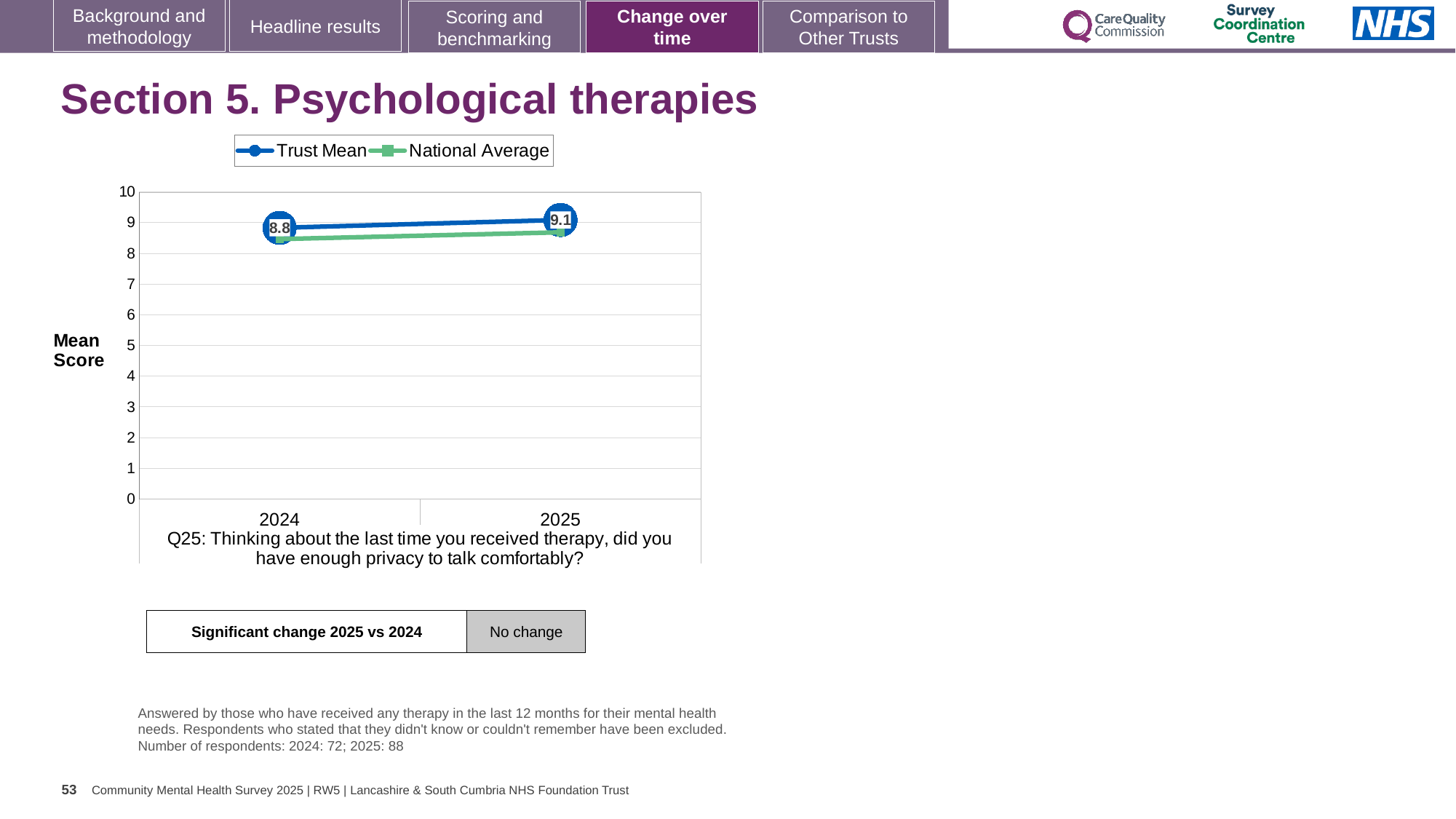
Does the Trust Mean rise or fall from 2024 to 2025? rise Which year has the higher Trust Mean, 2024 or 2025? 2025 How many series does the chart legend list? 2 Is the National Average value for 2025 greater or less than 9? less In 2025, which is higher, the Trust Mean or the National Average? Trust Mean Is the National Average value for 2024 greater or less than 9? less How many years are shown on the x axis of the chart? 2 By how much did the Trust Mean change from 2024 to 2025? 0.3 What kind of chart is shown on the slide? line chart In which year is the Trust Mean highest? 2025 What is the Trust Mean value for 2024? 8.8 What is the Trust Mean value for 2025? 9.1